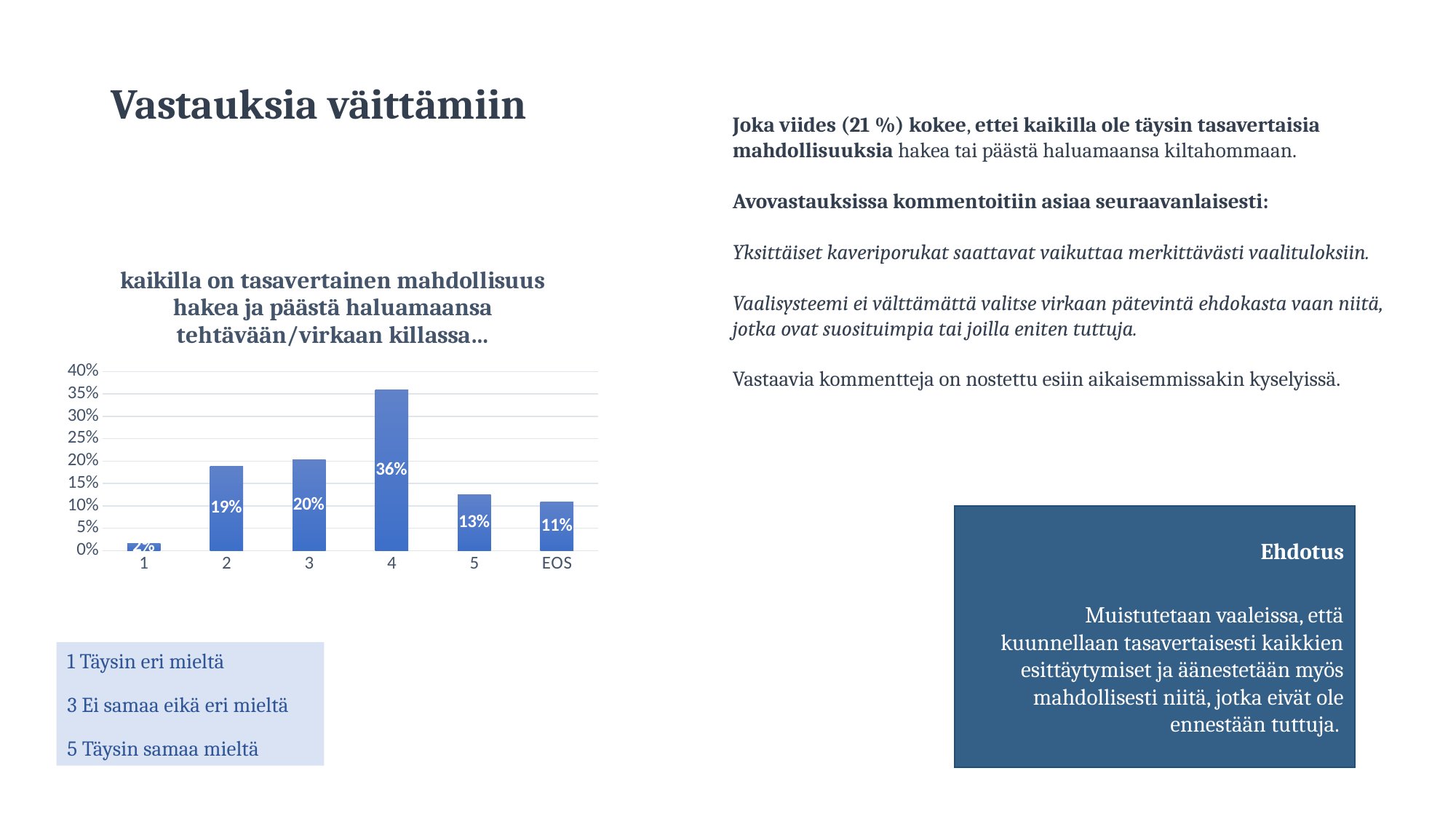
Which category has the lowest value in the chart? 1 What is the value for category 4 in the chart? 36% What is the value for category 3 in the chart? 20% How many categories are shown on the x axis of the chart? 6 Which category has the highest value in the chart? 4 Is the value for category 5 greater or less than 10%? greater Which has a larger value, category 5 or EOS? 5 What is the value for category 5 in the chart? 13% What is the value for category 2 in the chart? 19% What is the value for the EOS category in the chart? 11% What kind of chart is shown on the slide? bar chart What is the difference between the values for category 4 and category 3? 16 percentage points